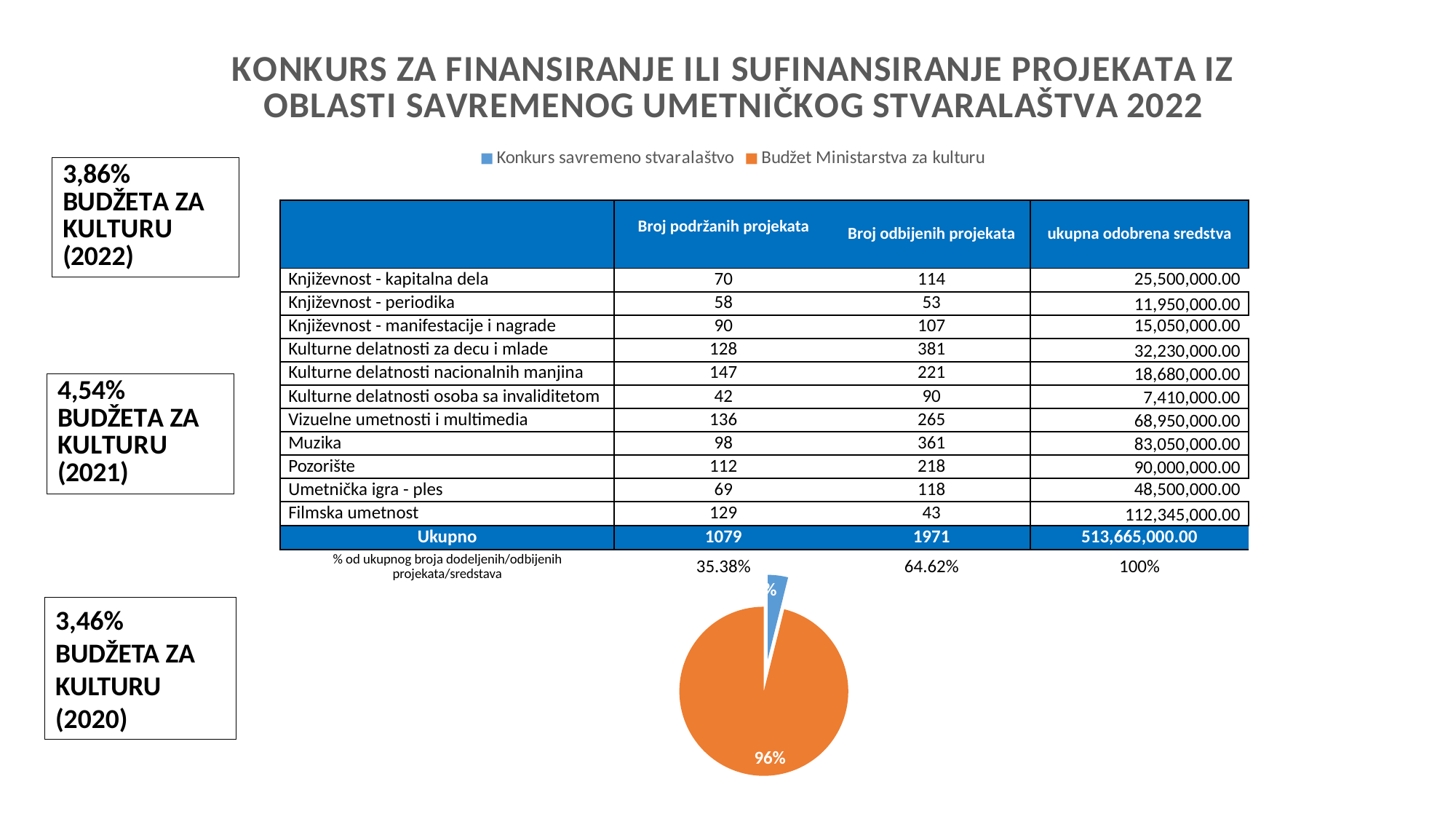
Which is larger in the pie chart, Konkurs savremeno stvaralaštvo or Budžet Ministarstva za kulturu? Budžet Ministarstva za kulturu What colour is the Budžet Ministarstva za kulturu slice in the pie chart? orange How many slices does the pie chart have? 2 Which slice of the pie chart is the smallest? Konkurs savremeno stvaralaštvo Which legend entry is shown in blue in the pie chart? Konkurs savremeno stvaralaštvo What kind of chart is shown on the slide? pie chart How many entries does the legend of the pie chart list? 2 Which slice of the pie chart is the largest? Budžet Ministarstva za kulturu What share of the pie does the Budžet Ministarstva za kulturu slice represent? 96%